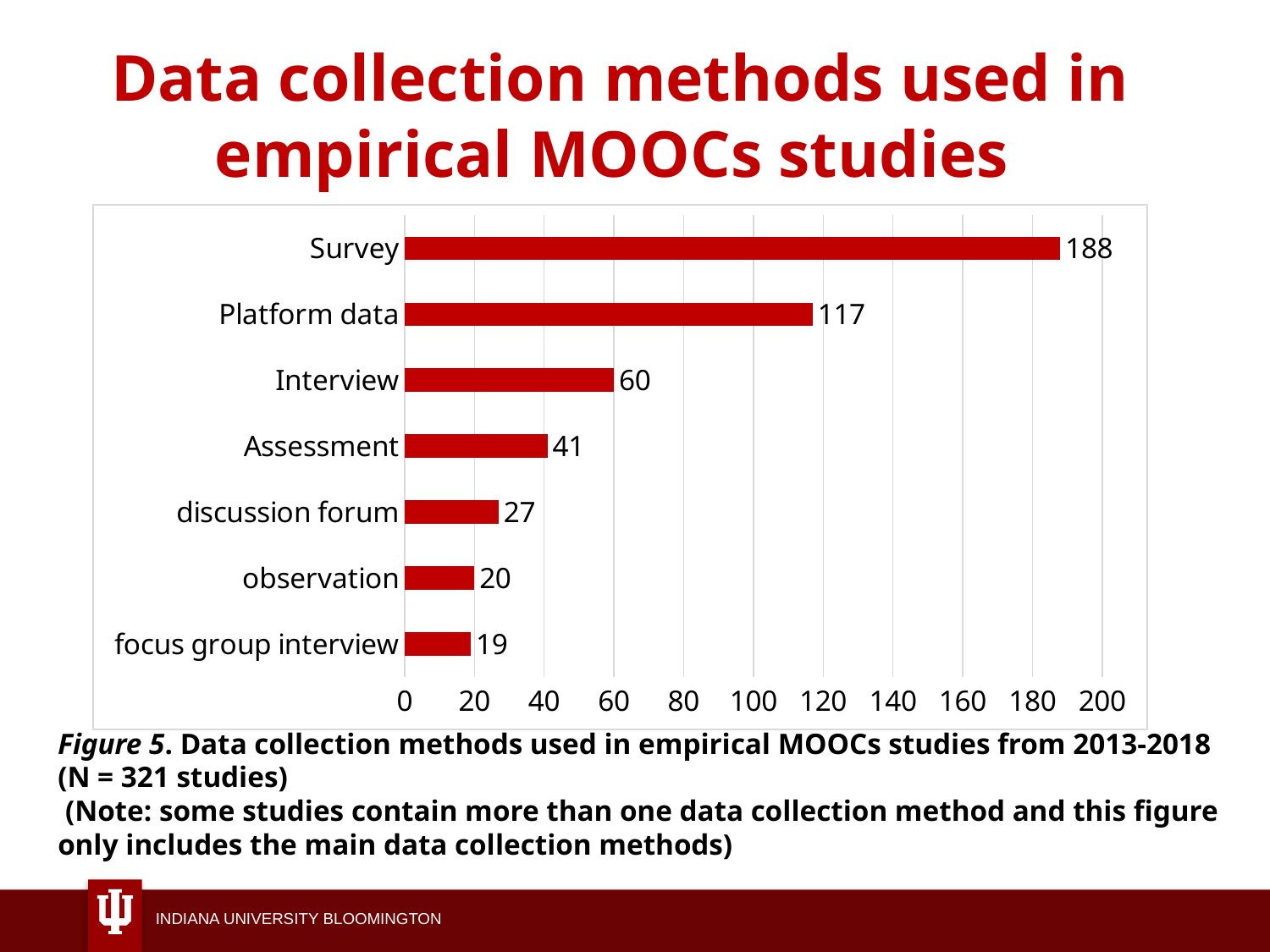
What is the difference between the values for observation and focus group interview? 1 What kind of chart is shown on the slide? bar chart What is the value for discussion forum? 27 Which data collection method has the lowest value? focus group interview How many data collection methods are shown in the chart? 7 What is the value for Platform data? 117 What is the value for Interview? 60 Which data collection method has the highest value? Survey What is the value for Survey? 188 Which is larger, the value for Assessment or the value for Interview? Interview Is the value for Platform data greater or less than 100? greater What is the difference between the values for Survey and Platform data? 71